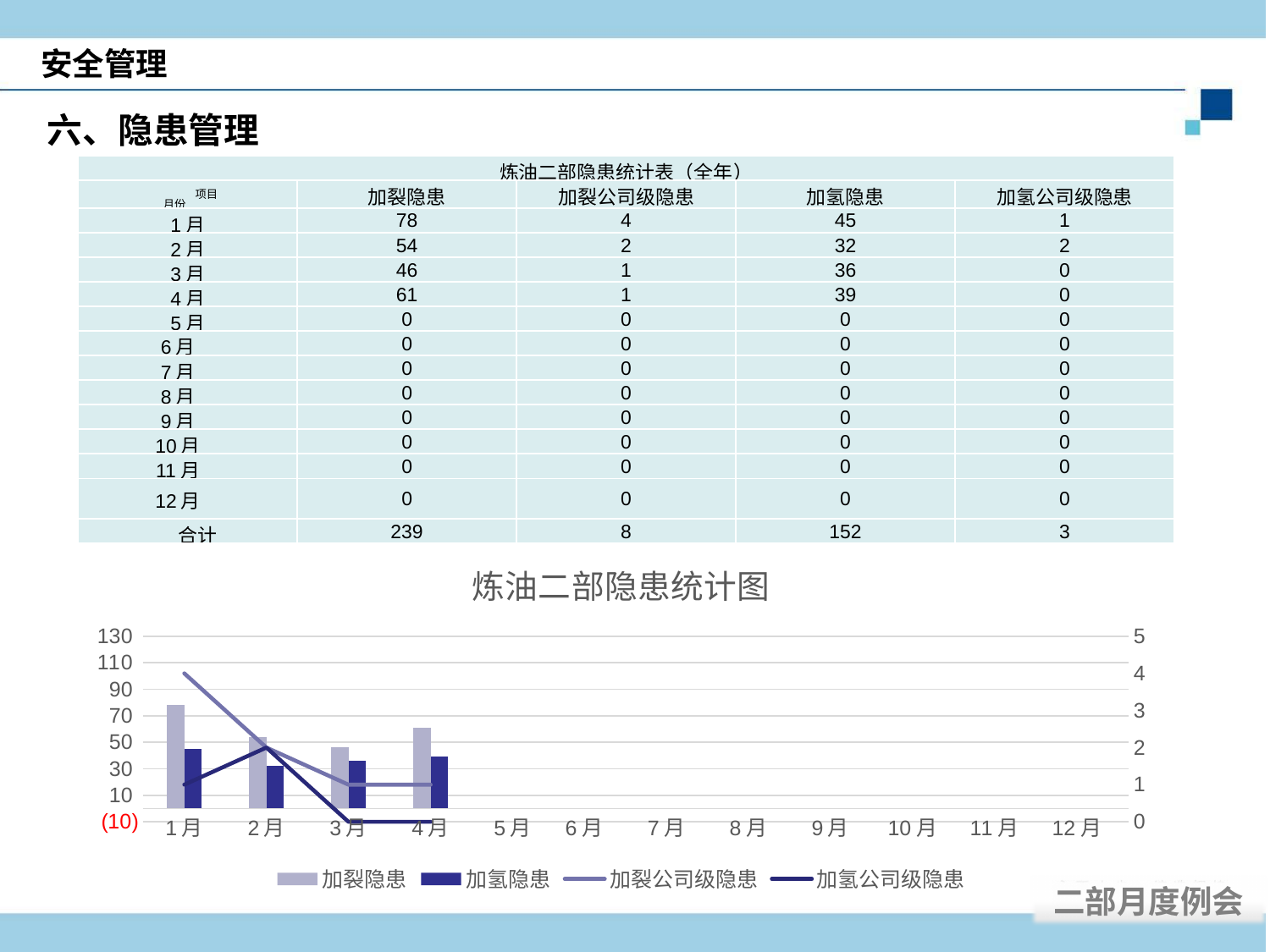
What is the title of the chart on the slide? 炼油二部隐患统计图 In 炼油二部隐患统计图, is the 加氢隐患 value for 2月 greater or less than 50? less In 炼油二部隐患统计图, is the 加裂隐患 value for 1月 greater or less than 70? greater What kind of chart is 炼油二部隐患统计图? A combined bar and line chart In 炼油二部隐患统计图, among 1月 to 4月, which month has the lowest 加裂隐患 bar? 3月 In 炼油二部隐患统计图, which month has the highest 加裂隐患 bar? 1月 According to the slide, what is the 加裂隐患 value for 4月? 61 In 炼油二部隐患统计图, does the 加裂公司级隐患 line rise or fall from 1月 to 4月? It falls According to the slide, what is the difference between 加裂隐患 and 加氢隐患 in 1月? 33 How many months are shown on the x axis of 炼油二部隐患统计图? 12 How many series does the legend of 炼油二部隐患统计图 list? 4 In 炼油二部隐患统计图, which is larger for 1月: 加裂隐患 or 加氢隐患? 加裂隐患